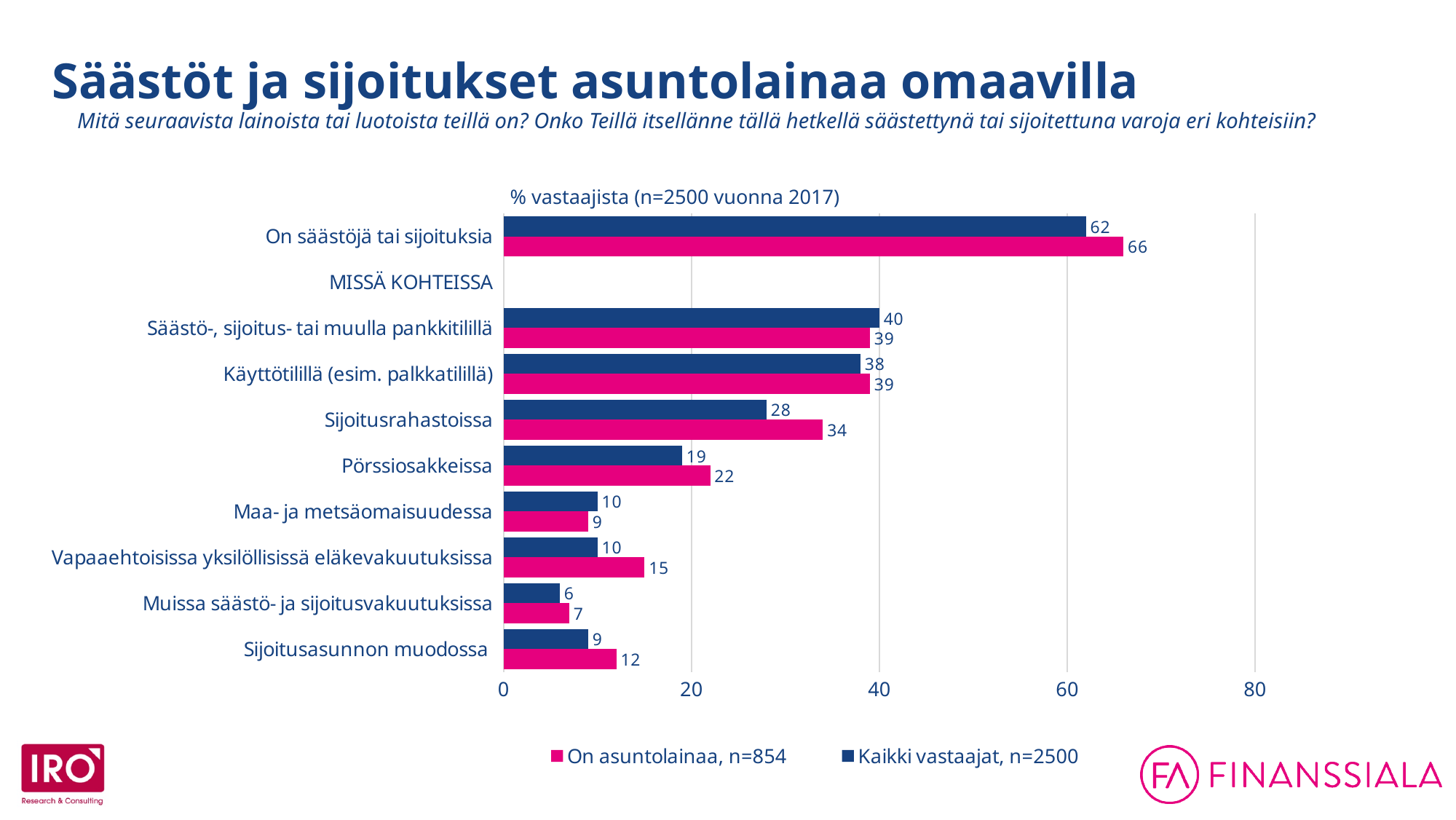
What is the value for 'On asuntolainaa, n=854' in the 'Sijoitusrahastoissa' category? 34 What is the value for 'Kaikki vastaajat, n=2500' in the 'Pörssiosakkeissa' category? 19 What kind of chart is shown on the slide? Bar chart What is the difference between the 'On asuntolainaa, n=854' and 'Kaikki vastaajat, n=2500' values for 'Sijoitusrahastoissa'? 6 For 'Maa- ja metsäomaisuudessa', which series has the larger value: 'On asuntolainaa, n=854' or 'Kaikki vastaajat, n=2500'? Kaikki vastaajat, n=2500 What is the title of the chart? % vastaajista (n=2500 vuonna 2017) Which category has the highest value for the 'On asuntolainaa, n=854' series? On säästöjä tai sijoituksia What is the difference between the 'On asuntolainaa, n=854' and 'Kaikki vastaajat, n=2500' values for 'On säästöjä tai sijoituksia'? 4 Which category has the lowest value for the 'Kaikki vastaajat, n=2500' series? Muissa säästö- ja sijoitusvakuutuksissa How many series does the legend list? 2 What is the value for 'Kaikki vastaajat, n=2500' in the 'Sijoitusasunnon muodossa' category? 9 What is the value for 'On asuntolainaa, n=854' in the 'Vapaaehtoisissa yksilöllisissä eläkevakuutuksissa' category? 15